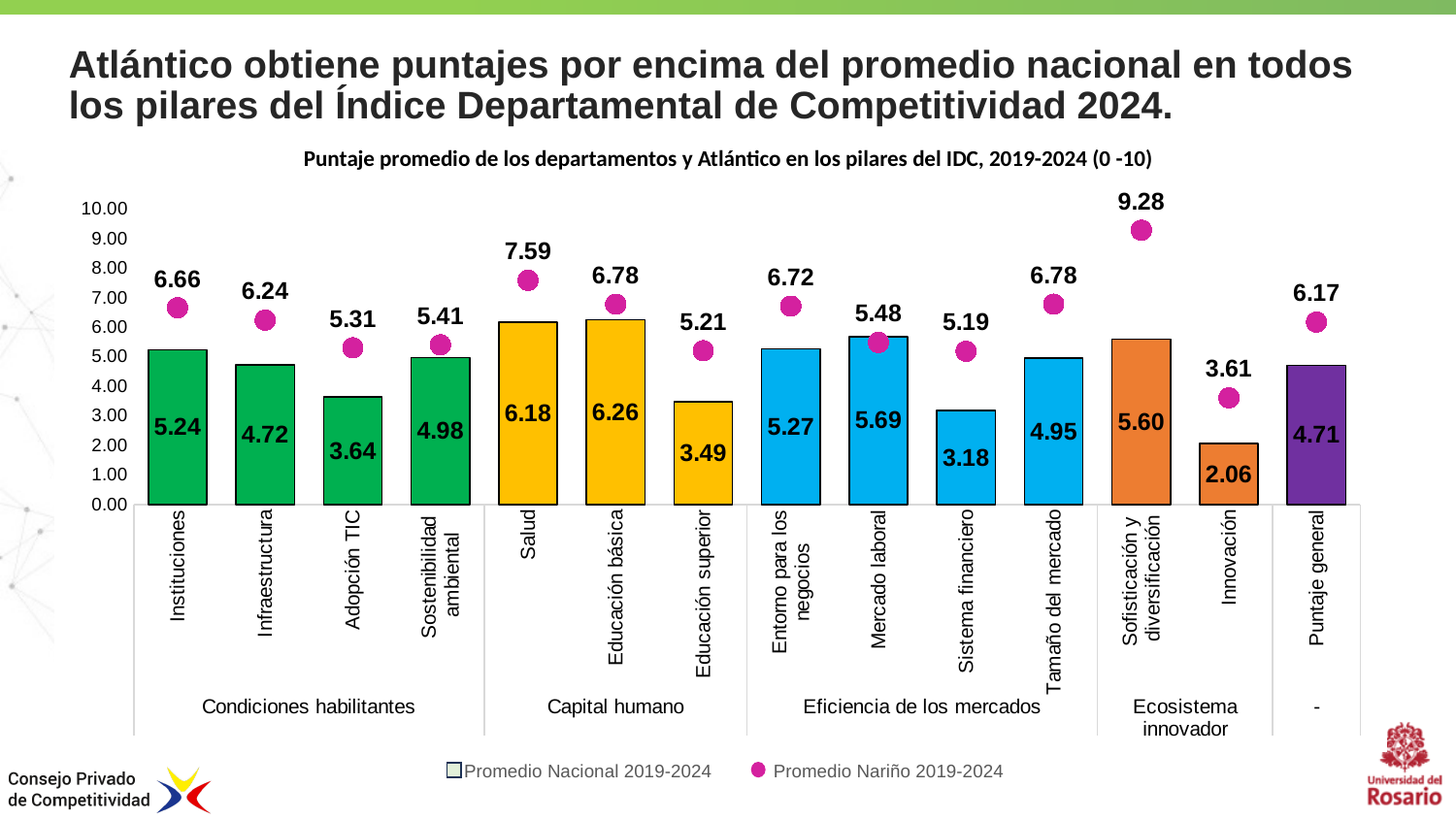
Which pillar has the highest Promedio Nariño 2019-2024 value? Sofisticación y diversificación What is the Promedio Nacional 2019-2024 value for Innovación? 2.06 What is the difference between the Promedio Nariño and Promedio Nacional values for Sofisticación y diversificación? 3.68 For Mercado laboral, which is larger: the Promedio Nacional 2019-2024 bar or the Promedio Nariño 2019-2024 dot? Promedio Nacional 2019-2024 Which pillar has the highest Promedio Nacional 2019-2024 bar? Educación básica What is the difference between the Promedio Nariño and Promedio Nacional values for Salud? 1.41 How many series does the legend list? 2 Which pillar has the lowest Promedio Nacional 2019-2024 bar? Innovación What is the Promedio Nacional 2019-2024 value for Puntaje general? 4.71 What kind of chart is shown on the slide? a combination chart with bars and dot markers What is the Promedio Nariño 2019-2024 value for Sofisticación y diversificación? 9.28 How many pillar categories are plotted on the x axis? 14